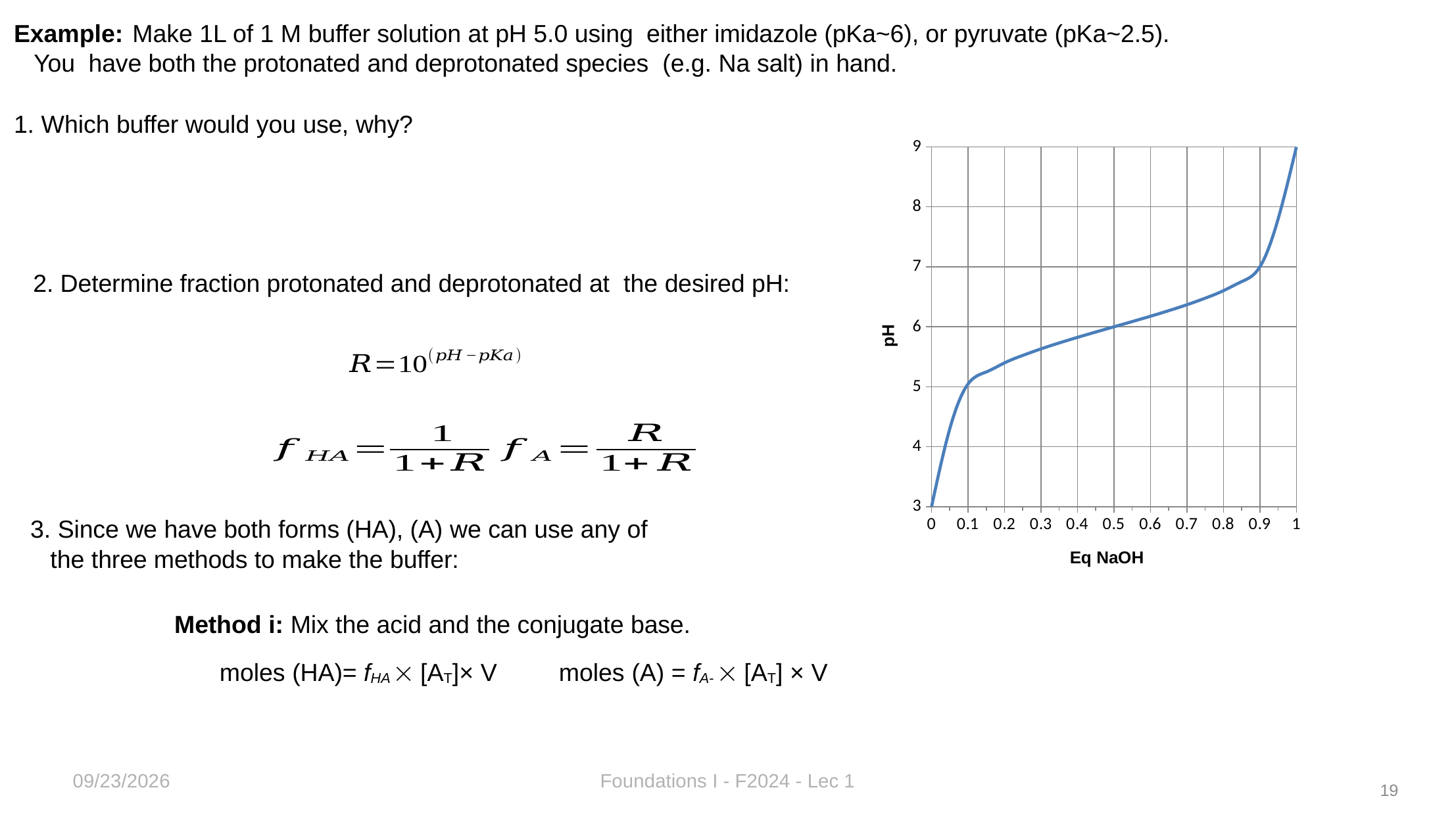
Does the pH rise or fall as Eq NaOH increases from 0 to 1? rise What is the label of the y axis of the chart? pH What is the pH at 0 Eq NaOH? 3 At which Eq NaOH value is the pH lowest? 0 What is the pH at 1 Eq NaOH? 9 What kind of chart is shown on the slide? line chart Is the pH at 0.3 Eq NaOH greater or less than 6? less What is the label of the x axis of the chart? Eq NaOH At which Eq NaOH value is the pH highest? 1 Is the pH at 0.2 Eq NaOH greater or less than 5? greater Is the pH at 0.8 Eq NaOH greater or less than 7? less Which is larger, the pH at 0.7 Eq NaOH or the pH at 0.3 Eq NaOH? 0.7 Eq NaOH